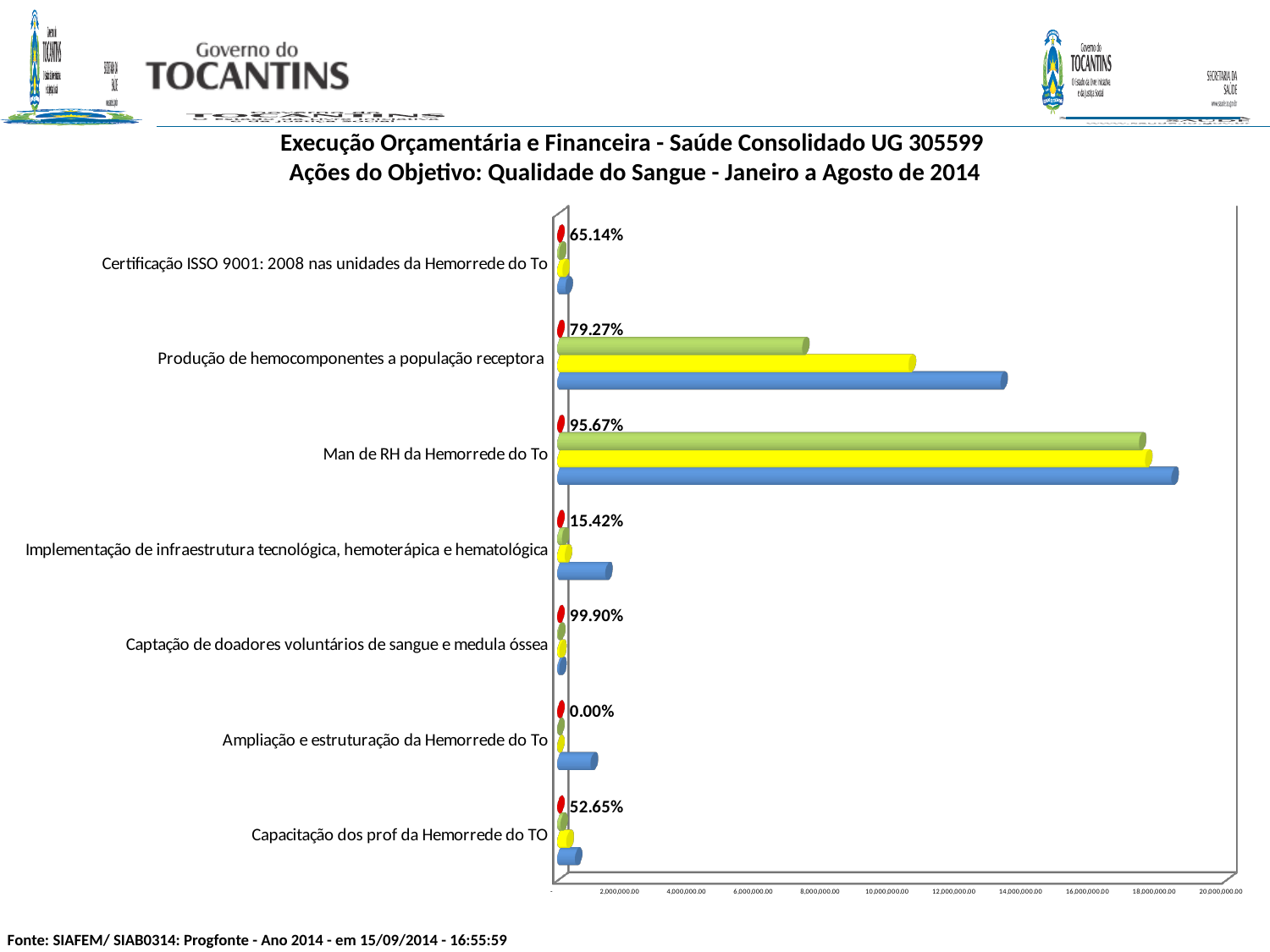
Which category has the lowest percentage label? Ampliação e estruturação da Hemorrede do To What percentage is shown for "Implementação de infraestrutura tecnológica, hemoterápica e hematológica"? 15.42% What kind of chart is shown on the slide? Bar chart Is the blue bar for "Man de RH da Hemorrede do To" greater or less than 16,000,000.00? greater Is the blue bar for "Implementação de infraestrutura tecnológica, hemoterápica e hematológica" greater or less than 2,000,000.00? less What percentage is shown for "Man de RH da Hemorrede do To"? 95.67% How many categories are shown on the chart? 7 What is the difference between the percentage for "Man de RH da Hemorrede do To" and the percentage for "Produção de hemocomponentes a população receptora"? 16.40% Which category has the highest percentage label? Captação de doadores voluntários de sangue e medula óssea Which has a higher percentage: "Produção de hemocomponentes a população receptora" or "Certificação ISSO 9001: 2008 nas unidades da Hemorrede do To"? Produção de hemocomponentes a população receptora What percentage is shown for "Captação de doadores voluntários de sangue e medula óssea"? 99.90% What percentage is shown for "Capacitação dos prof da Hemorrede do TO"? 52.65%